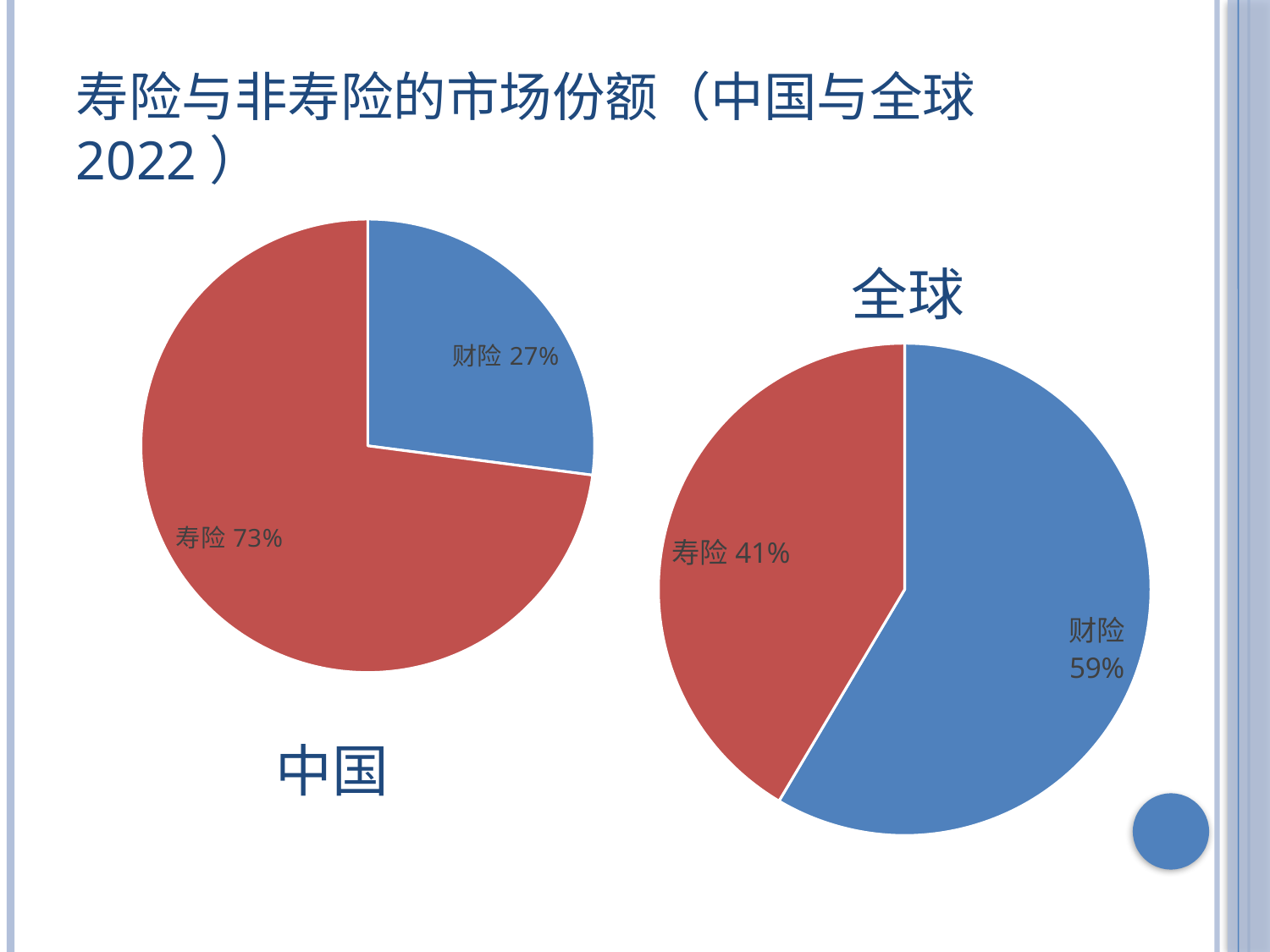
In the 中国 pie chart, which slice is the largest? 寿险 In the 全球 pie chart, which slice is the smallest? 寿险 How many slices does the 全球 pie chart have? 2 In the 中国 pie chart, what share does 财险 have? 27% In the 全球 pie chart, what colour is the 财险 slice? blue In the 中国 pie chart, what share does 寿险 have? 73% In the 全球 pie chart, what share does 财险 have? 59% In the 中国 pie chart, what is the difference between the 寿险 share and the 财险 share? 46% In the 全球 pie chart, what share does 寿险 have? 41% In the 全球 pie chart, what is the difference between the 财险 share and the 寿险 share? 18% What type of chart is the 中国 chart? pie chart Which is larger: the 寿险 share in the 中国 chart or the 寿险 share in the 全球 chart? 中国